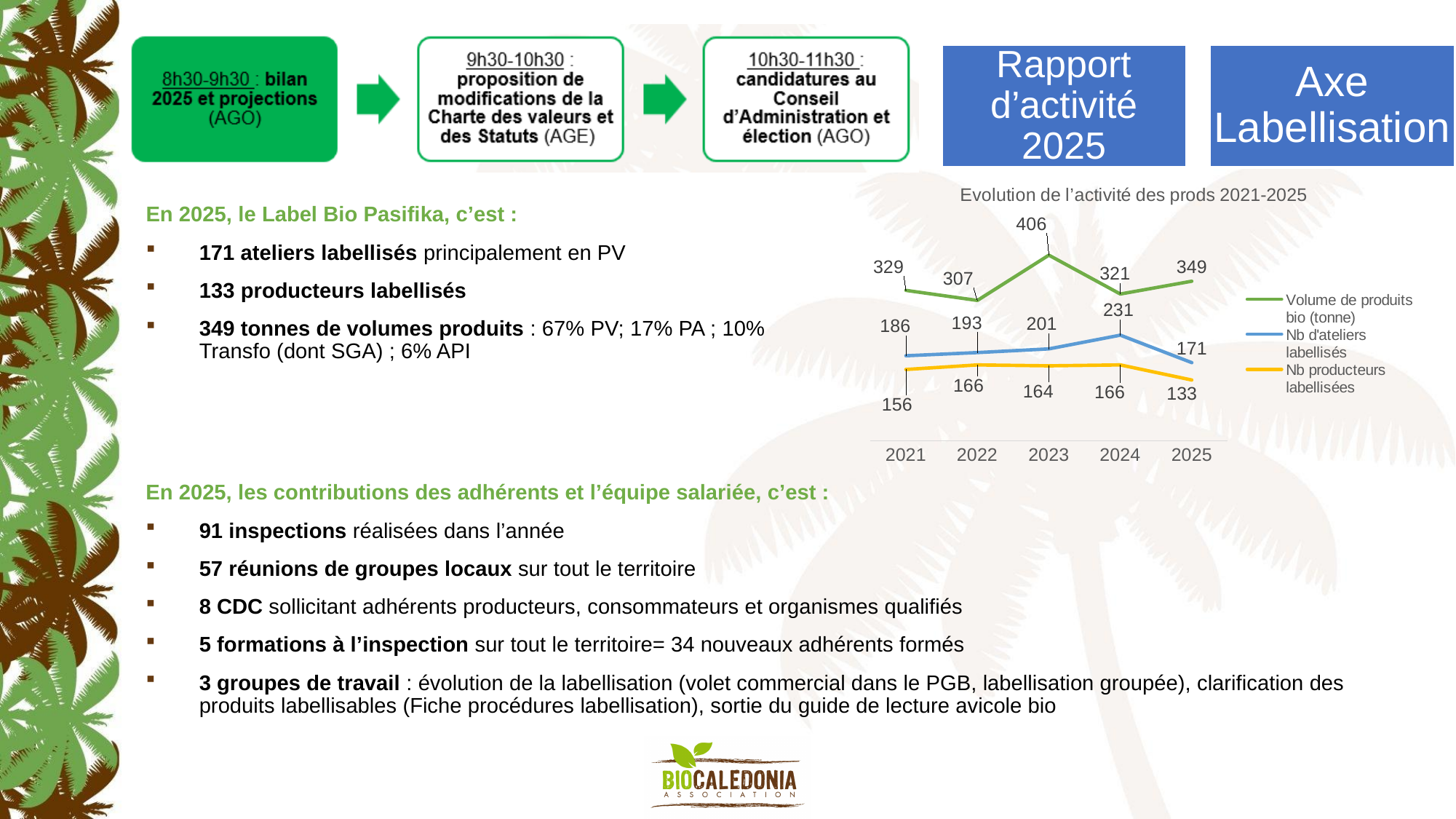
What is the value of 'Nb d'ateliers labellisés' in 2024? 231 How many years are shown on the x axis of the chart? 5 What type of chart is shown on the slide? Line chart What is the title of the chart? Evolution de l'activité des prods 2021-2025 How many series does the chart legend list? 3 In which year is 'Nb producteurs labellisées' lowest? 2025 What is the value of 'Nb producteurs labellisées' in 2025? 133 In which year is 'Volume de produits bio (tonne)' highest? 2023 Which is larger: 'Volume de produits bio (tonne)' in 2021 or in 2025? 2025 What is the value of 'Volume de produits bio (tonne)' in 2023? 406 Does 'Nb producteurs labellisées' rise or fall from 2024 to 2025? Fall What is the difference between 'Nb d'ateliers labellisés' in 2024 and in 2025? 60